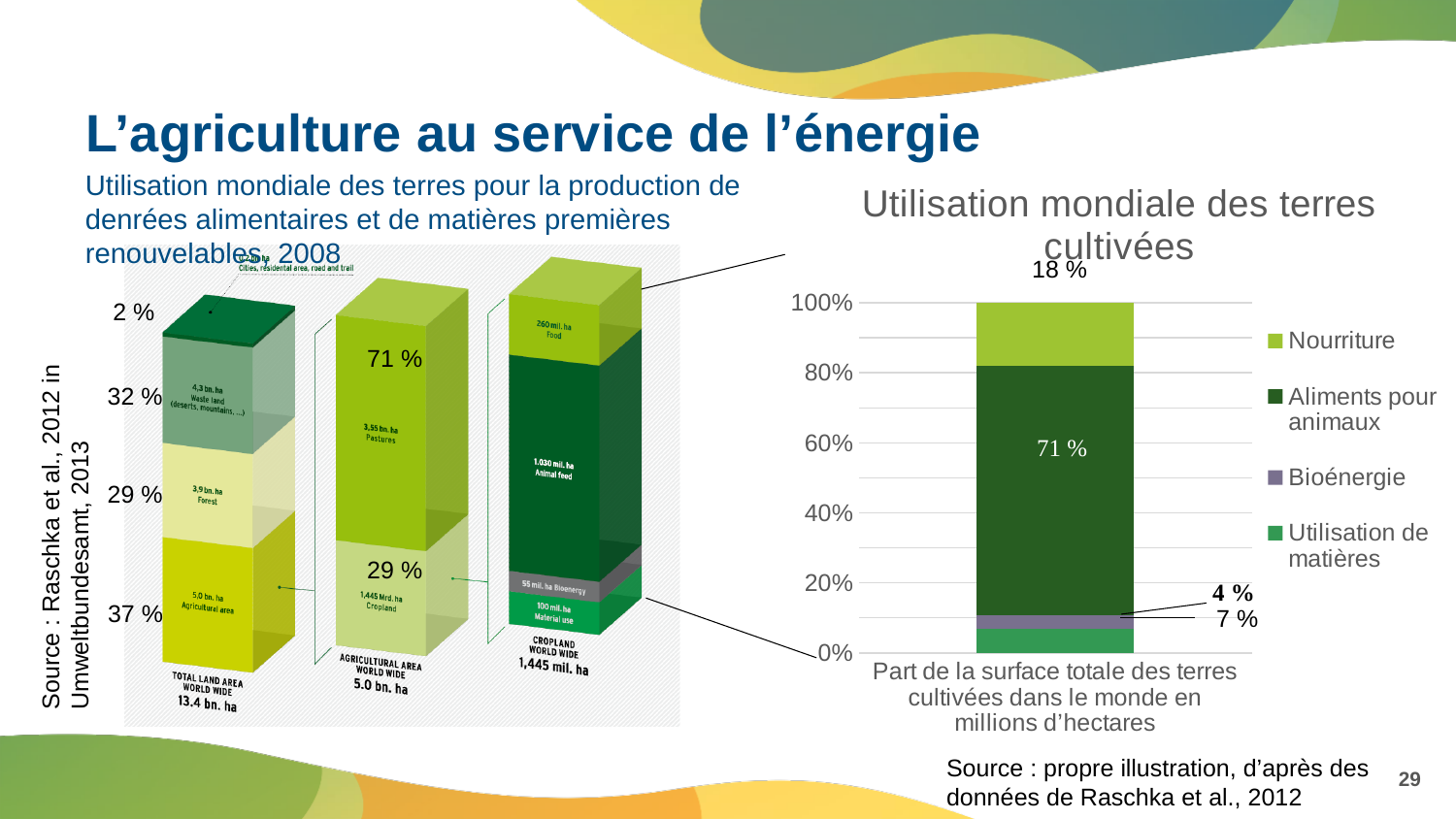
In the chart 'Utilisation mondiale des terres cultivées', what is the difference between Aliments pour animaux and Nourriture? 53 % In the chart 'Utilisation mondiale des terres cultivées', which category has the largest share? Aliments pour animaux In the chart 'Utilisation mondiale des terres cultivées', what is the highest value shown on the vertical axis? 100% What kind of chart is 'Utilisation mondiale des terres cultivées'? Stacked bar chart In the chart 'Utilisation mondiale des terres cultivées', what is the value for Aliments pour animaux? 71 % In the chart 'Utilisation mondiale des terres cultivées', how many series does the legend list? 4 In the chart 'Utilisation mondiale des terres cultivées', what is the total of the stacked bar? 100 % In the chart 'Utilisation mondiale des terres cultivées', what is the value for Nourriture? 18 % In the chart 'Utilisation mondiale des terres cultivées', which is larger, Utilisation de matières or Bioénergie? Utilisation de matières In the chart 'Utilisation mondiale des terres cultivées', which category has the smallest share? Bioénergie In the chart 'Utilisation mondiale des terres cultivées', what is the value for Utilisation de matières? 7 % In the chart 'Utilisation mondiale des terres cultivées', what is the value for Bioénergie? 4 %